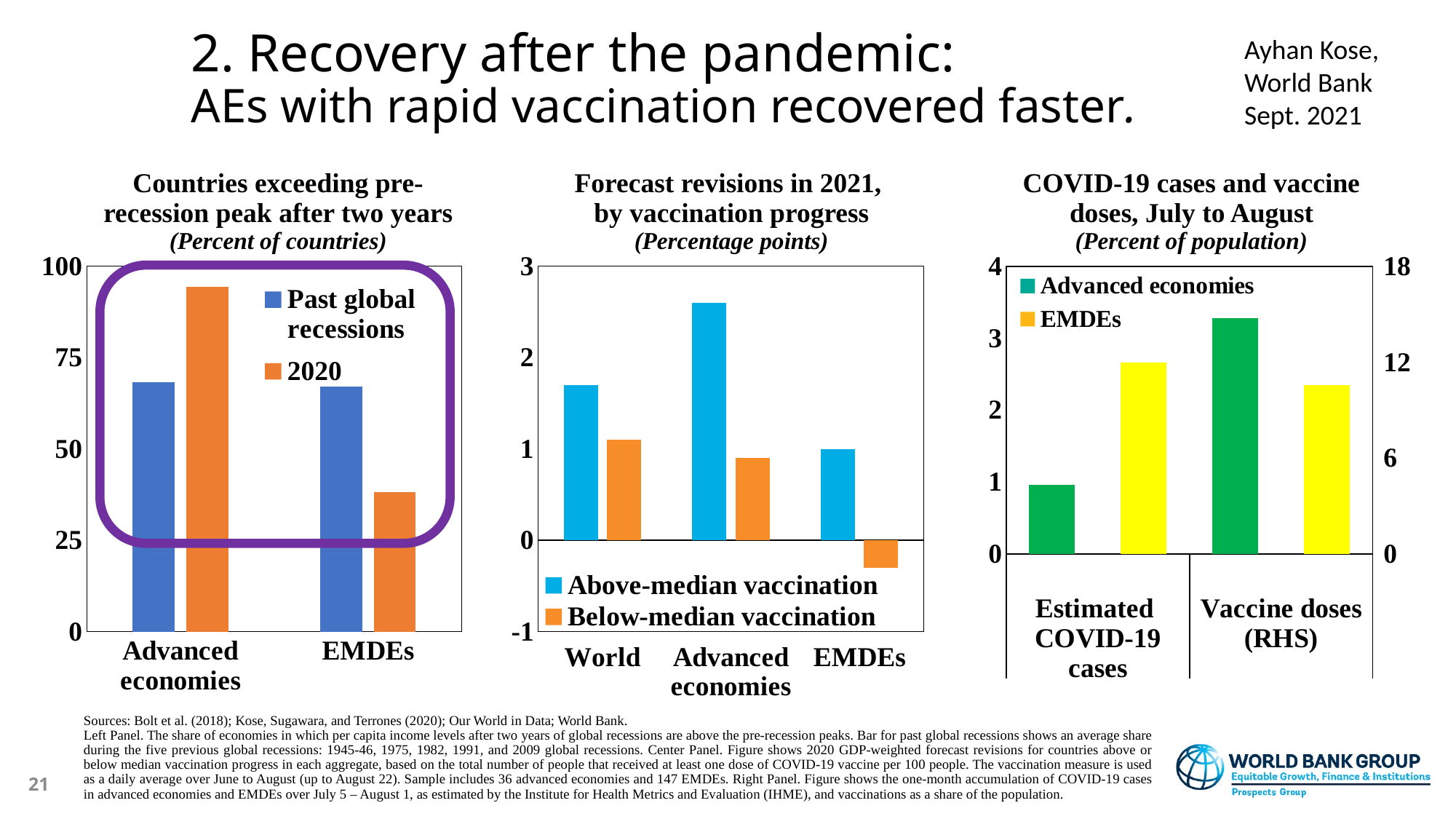
In the right chart (COVID-19 cases and vaccine doses, July to August), which series has the higher value for Estimated COVID-19 cases: Advanced economies or EMDEs? EMDEs What kind of chart is the right chart (COVID-19 cases and vaccine doses, July to August)? bar chart In the right chart (COVID-19 cases and vaccine doses, July to August), which series has the higher value for Vaccine doses (RHS): Advanced economies or EMDEs? Advanced economies In the center chart (Forecast revisions in 2021, by vaccination progress), is the Below-median vaccination value for EMDEs greater or less than 0? less In the left chart (Countries exceeding pre-recession peak after two years), how many series does the legend list? 2 In the center chart (Forecast revisions in 2021, by vaccination progress), which category has the highest Above-median vaccination value? Advanced economies In the left chart (Countries exceeding pre-recession peak after two years), which series has the higher value for Advanced economies: Past global recessions or 2020? 2020 In the right chart (COVID-19 cases and vaccine doses, July to August), is the Advanced economies value for Vaccine doses (RHS) greater or less than 12 on the right-hand axis? greater In the center chart (Forecast revisions in 2021, by vaccination progress), which category has the lowest Below-median vaccination value? EMDEs In the left chart (Countries exceeding pre-recession peak after two years), is the 2020 value for EMDEs greater or less than 50? less In the center chart (Forecast revisions in 2021, by vaccination progress), how many categories are shown on the x axis? 3